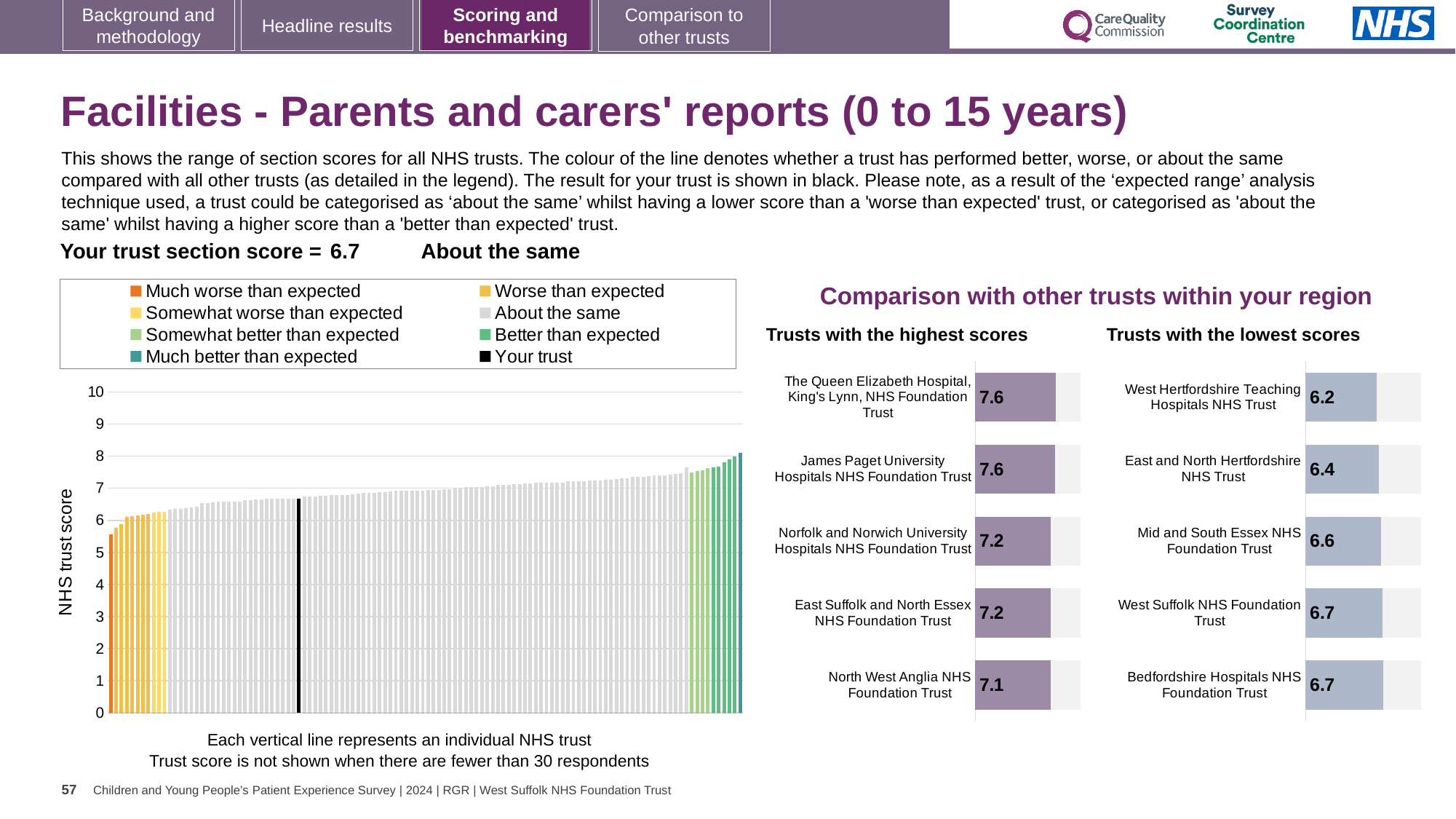
In the 'Trusts with the lowest scores' chart, which trust has the lowest score? West Hertfordshire Teaching Hospitals NHS Trust What kind of chart is the main chart on the left of the slide? bar chart What is the y-axis label of the main chart on the left? NHS trust score How many entries does the legend of the main chart on the left list? 8 In the 'Trusts with the highest scores' chart, which trust has the lowest score? North West Anglia NHS Foundation Trust In the main chart on the left, is the lowest trust score greater or less than 6? less In the 'Trusts with the highest scores' chart, what is the score for The Queen Elizabeth Hospital, King's Lynn, NHS Foundation Trust? 7.6 How many trusts are shown in the 'Trusts with the lowest scores' chart? 5 In the main chart on the left, do the trust scores rise or fall from left to right? rise In the 'Trusts with the lowest scores' chart, which has the higher score: East and North Hertfordshire NHS Trust or Mid and South Essex NHS Foundation Trust? Mid and South Essex NHS Foundation Trust In the 'Trusts with the lowest scores' chart, what is the score for Mid and South Essex NHS Foundation Trust? 6.6 In the 'Trusts with the highest scores' chart, what is the difference between the scores of The Queen Elizabeth Hospital, King's Lynn and North West Anglia NHS Foundation Trust? 0.5